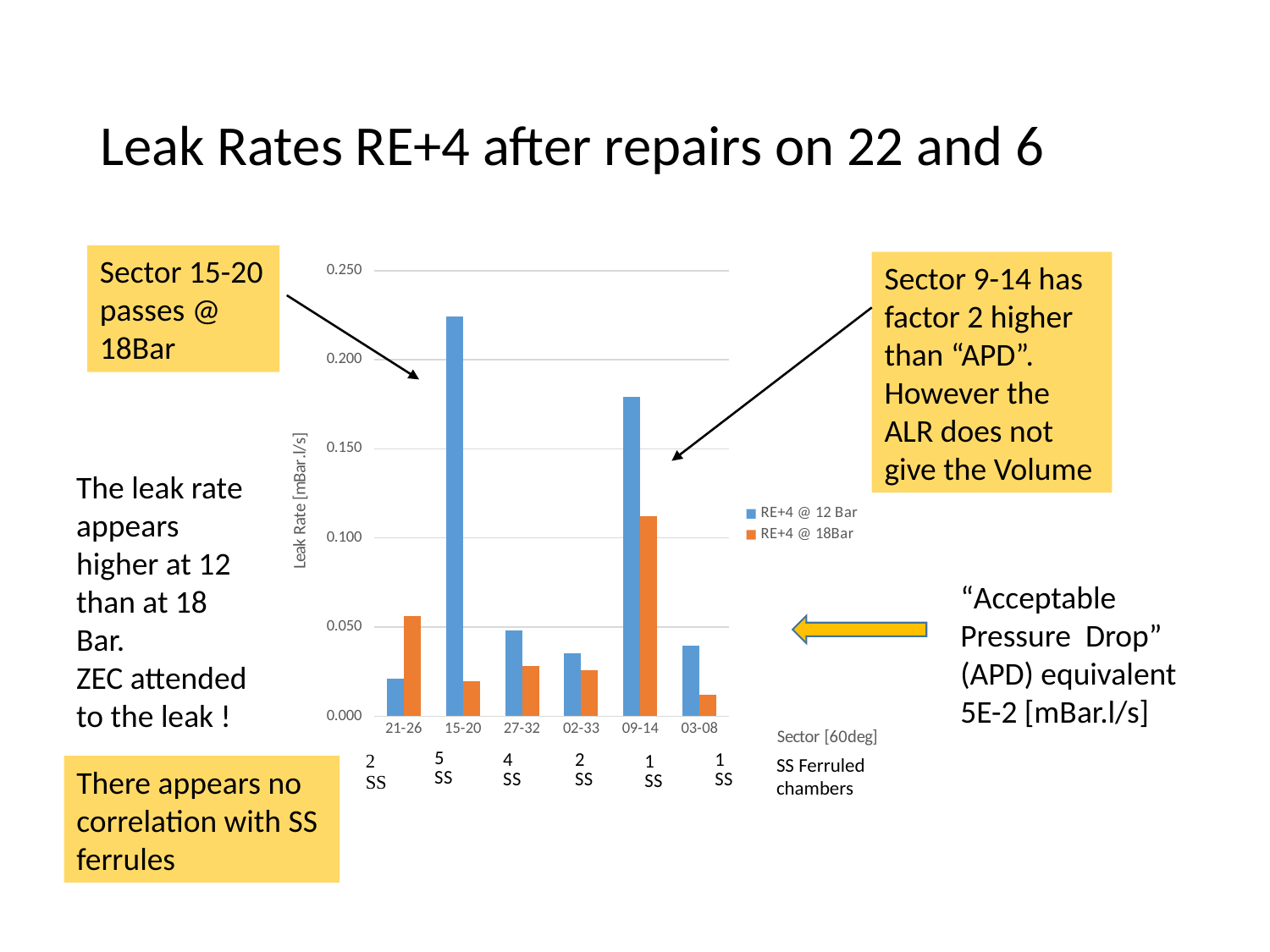
What is the label of the vertical axis of the chart? Leak Rate [mBar.l/s] For sector 21-26, which series has the larger value, RE+4 @ 12 Bar or RE+4 @ 18Bar? RE+4 @ 18Bar How many series does the chart legend list? 2 Which sector has the lowest RE+4 @ 18Bar leak rate? 03-08 Is the RE+4 @ 12 Bar value for sector 09-14 greater or less than 0.150? greater Is the RE+4 @ 12 Bar value for sector 21-26 greater or less than 0.050? less Which sector has the highest RE+4 @ 18Bar leak rate? 09-14 Is the RE+4 @ 12 Bar value for sector 15-20 greater or less than 0.200? greater How many sector categories are shown on the x axis of the chart? 6 What kind of chart is shown on the slide? Bar chart Which sector has the highest RE+4 @ 12 Bar leak rate? 15-20